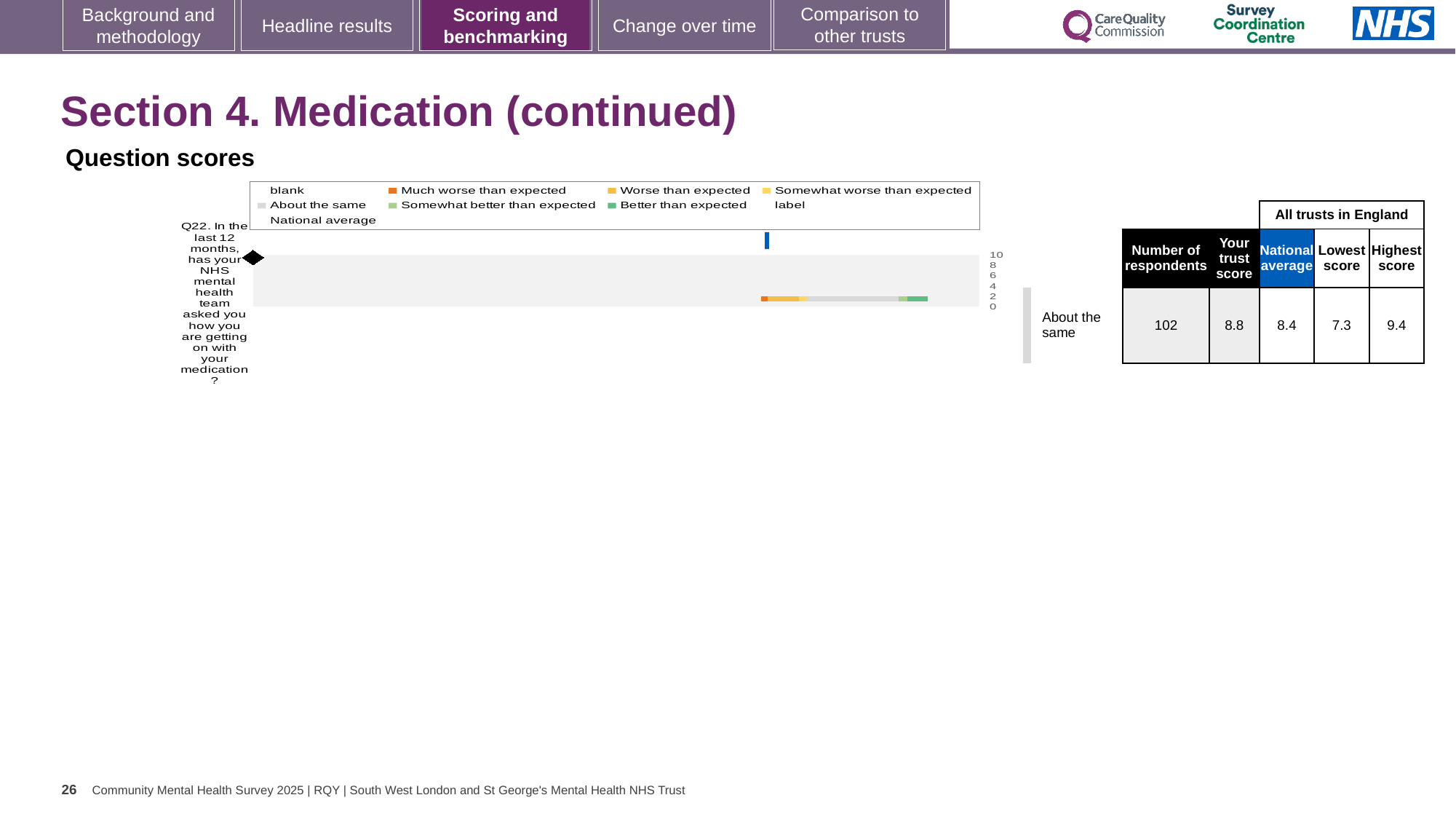
How many entries does the chart's legend list? 9 Which question number is plotted in the chart? Q22 In the table beside the chart, what is the Highest score among all trusts in England for Q22? 9.4 What kind of chart is shown under 'Question scores'? bar chart In the table beside the chart, what is the 'Your trust score' for Q22? 8.8 In the table beside the chart, how many respondents answered Q22? 102 How many questions (categories) are plotted in the chart? 1 For Q22, what is the difference between the Highest score and the Lowest score in the table? 2.1 In the table beside the chart, what is the Lowest score among all trusts in England for Q22? 7.3 For Q22, which is larger: the trust score or the National average? the trust score In the table beside the chart, what is the National average for Q22? 8.4 What benchmark category label is shown next to the chart for Q22? About the same